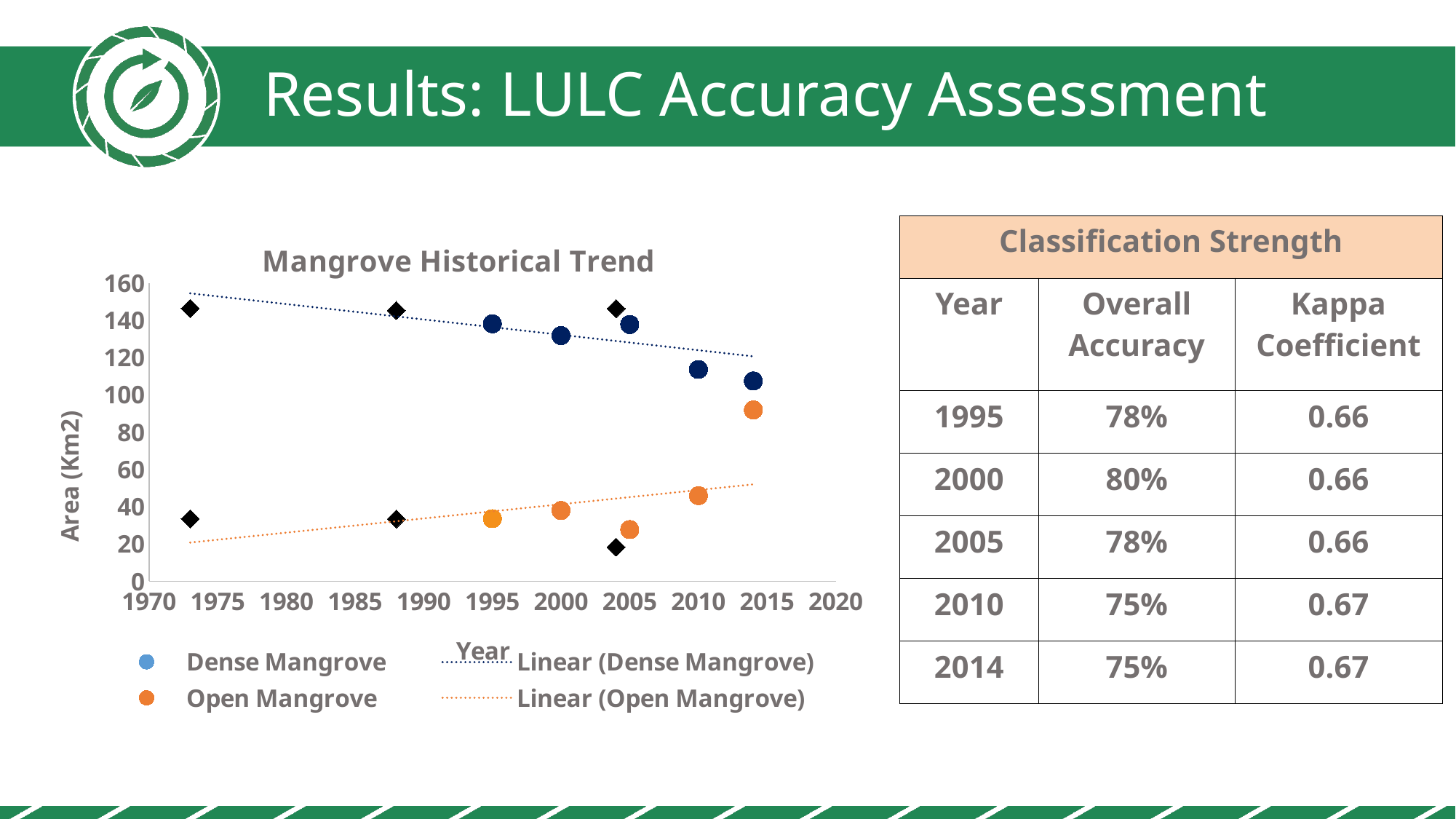
What type of chart is the Mangrove Historical Trend chart? scatter chart What is the title of the chart on the slide? Mangrove Historical Trend Is the Dense Mangrove value for 2014 greater or less than 120? less In 2010, which is larger: the Dense Mangrove value or the Open Mangrove value? Dense Mangrove How many entries does the legend of the Mangrove Historical Trend chart list? 4 What is the label of the vertical axis of the Mangrove Historical Trend chart? Area (Km2) Is the Dense Mangrove value for 1995 greater or less than 120? greater Do the Dense Mangrove values rise or fall over the years in the Mangrove Historical Trend chart? fall Is the Open Mangrove value for 2014 greater or less than 80? greater Do the Open Mangrove values generally rise or fall over the years in the Mangrove Historical Trend chart? rise In which year is the Open Mangrove value highest? 2014